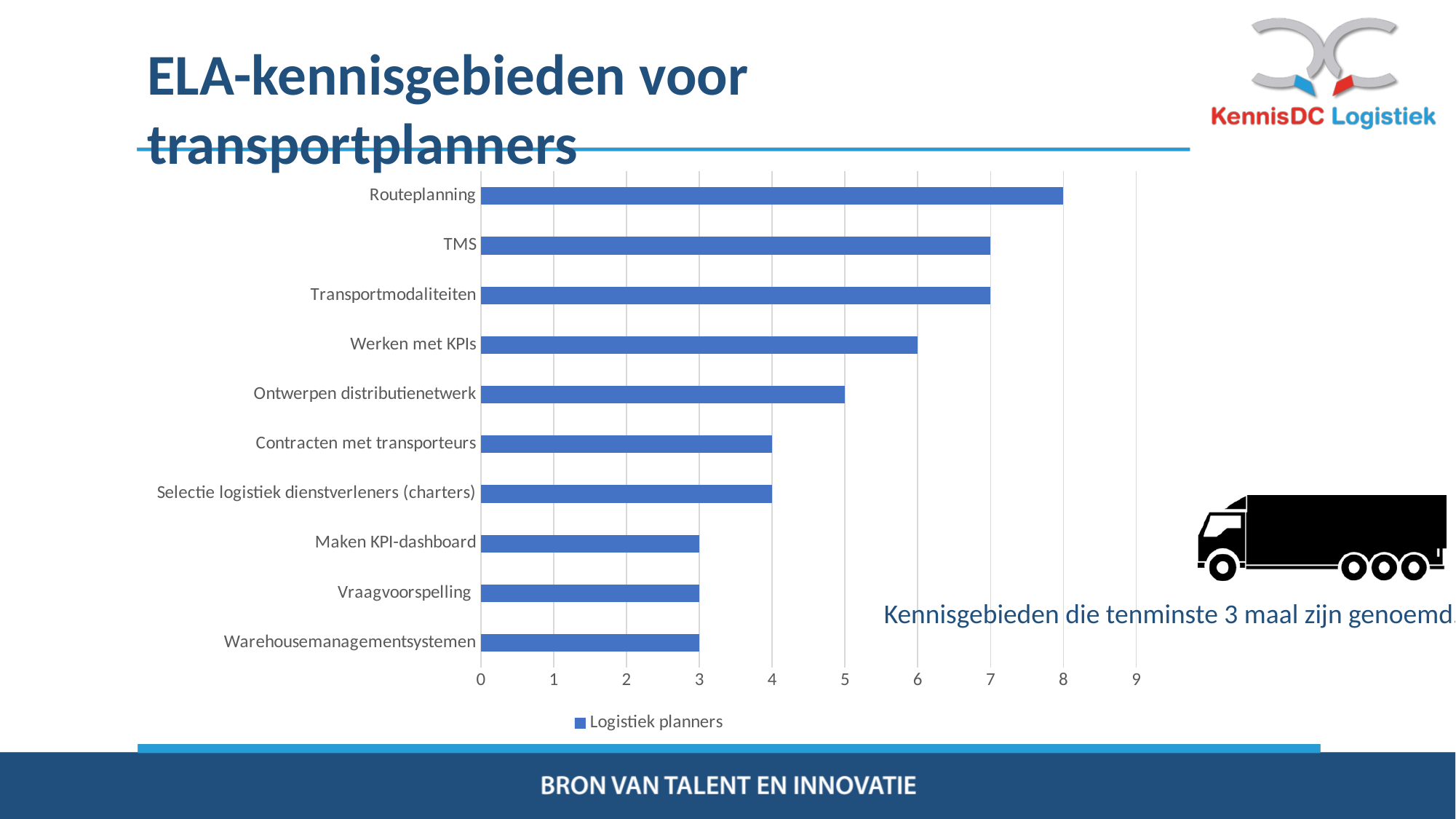
Is the value for Transportmodaliteiten greater or less than 5? greater How many categories are shown in the chart? 10 Which is larger, the value for TMS or the value for Contracten met transporteurs? TMS What is the value for Vraagvoorspelling? 3 What is the name of the series shown in the legend? Logistiek planners What kind of chart is shown on the slide? bar chart What is the value for Routeplanning? 8 Which category has the highest value? Routeplanning What is the value for Ontwerpen distributienetwerk? 5 What is the difference between the values for Routeplanning and Werken met KPIs? 2 What is the value for Werken met KPIs? 6 How many series does the legend list? 1